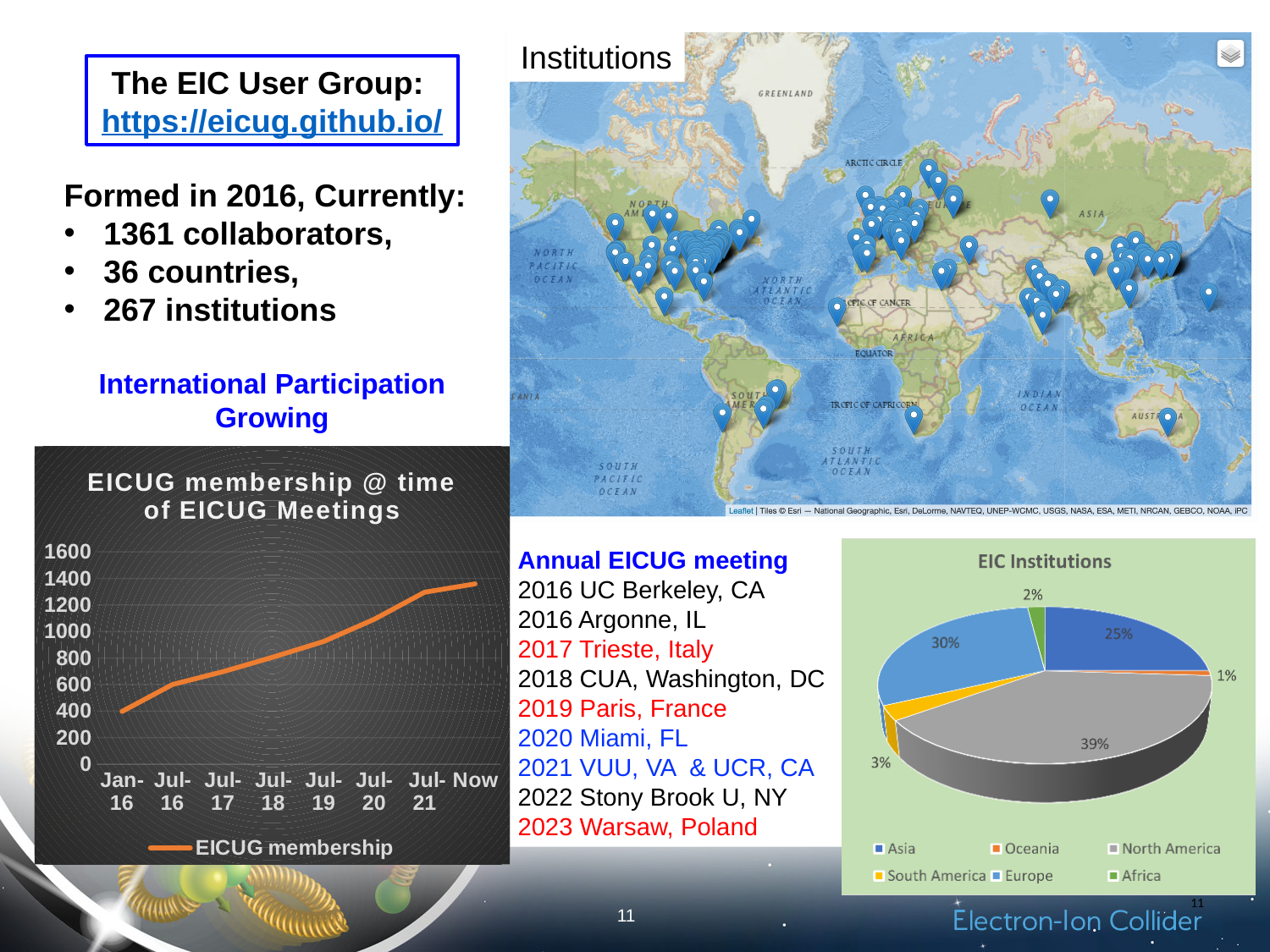
In the 'EIC Institutions' pie chart, what share is North America? 39% In the 'EIC Institutions' pie chart, what share is Europe? 30% In the 'EICUG membership @ time of EICUG Meetings' chart, is the value for Jan-16 greater or less than 600? less What kind of chart is the 'EIC Institutions' chart? pie chart In the 'EICUG membership @ time of EICUG Meetings' chart, do the values rise or fall from Jan-16 to Now? rise How many regions does the legend of the 'EIC Institutions' pie chart list? 6 In the 'EICUG membership @ time of EICUG Meetings' chart, which point has the highest membership? Now In the 'EIC Institutions' pie chart, which region has the smallest share? Oceania In the 'EICUG membership @ time of EICUG Meetings' chart, is the value for Jul-20 greater or less than 1000? greater In the 'EICUG membership @ time of EICUG Meetings' chart, how many points are plotted along the x axis? 8 What kind of chart is the 'EICUG membership @ time of EICUG Meetings' chart? line chart In the 'EICUG membership @ time of EICUG Meetings' chart, what series name does the legend show? EICUG membership